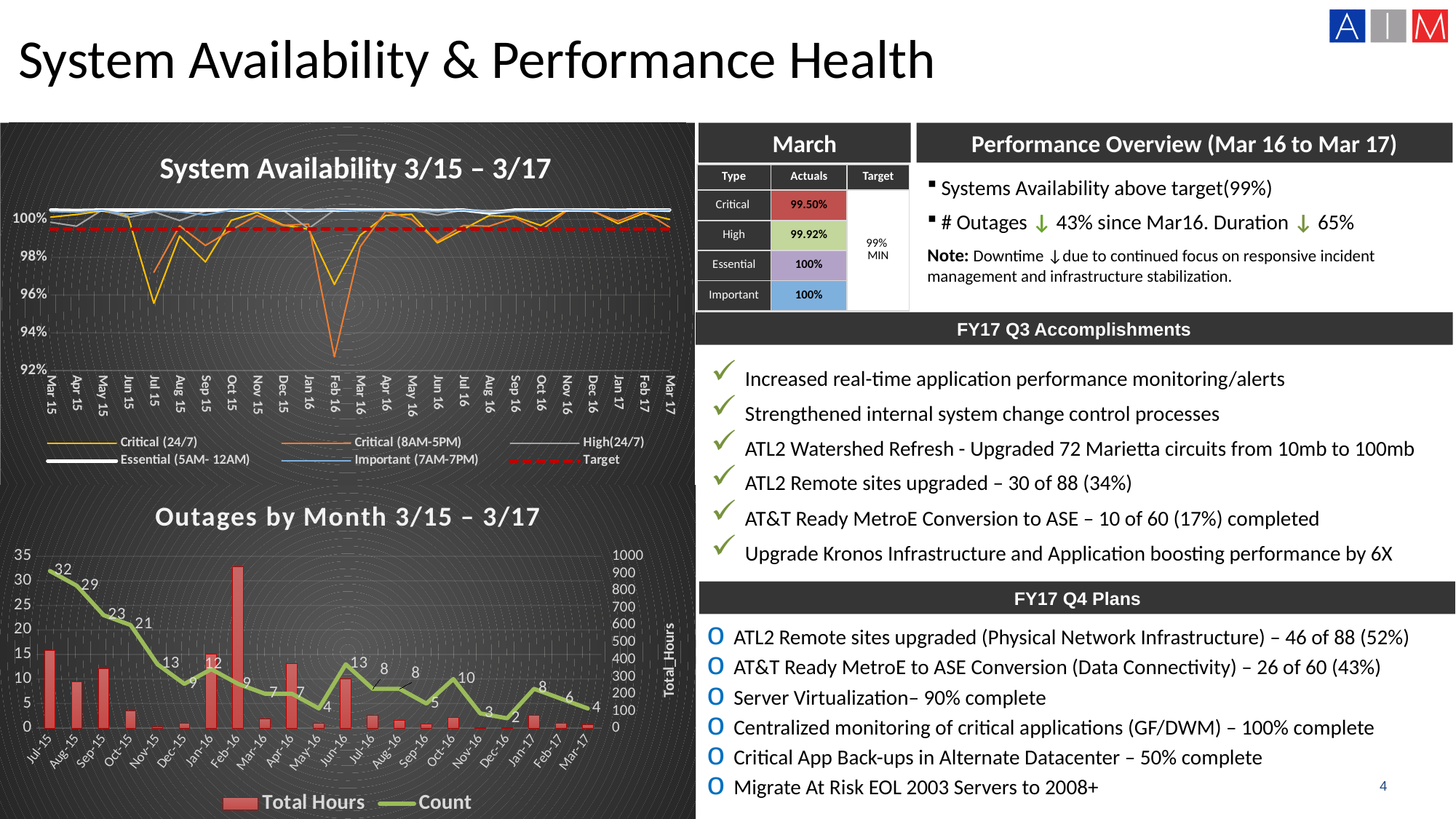
In the 'Outages by Month 3/15 – 3/17' chart, does the Count rise or fall from Jul-15 to Nov-15? fall In the 'Outages by Month 3/15 – 3/17' chart, what is the difference between the Count for Jul-15 and the Count for Aug-15? 3 In the 'Outages by Month 3/15 – 3/17' chart, what is the Count for Jul-15? 32 In the 'System Availability 3/15 – 3/17' chart, is the value for Critical (8AM-5PM) in Feb 16 greater or less than 94%? less In the 'Outages by Month 3/15 – 3/17' chart, which month has the lowest Count? Dec-16 In the 'Outages by Month 3/15 – 3/17' chart, is the Total Hours value for Feb-16 greater or less than 800? greater How many series does the legend of the 'Outages by Month 3/15 – 3/17' chart list? 2 In the 'Outages by Month 3/15 – 3/17' chart, which month has the larger Count, May-16 or Jun-16? Jun-16 What kind of chart is the 'Outages by Month 3/15 – 3/17' chart? A combination bar and line chart How many series does the legend of the 'System Availability 3/15 – 3/17' chart list? 6 In the 'Outages by Month 3/15 – 3/17' chart, which month has the highest Count? Jul-15 In the 'Outages by Month 3/15 – 3/17' chart, which month has the tallest Total Hours bar? Feb-16